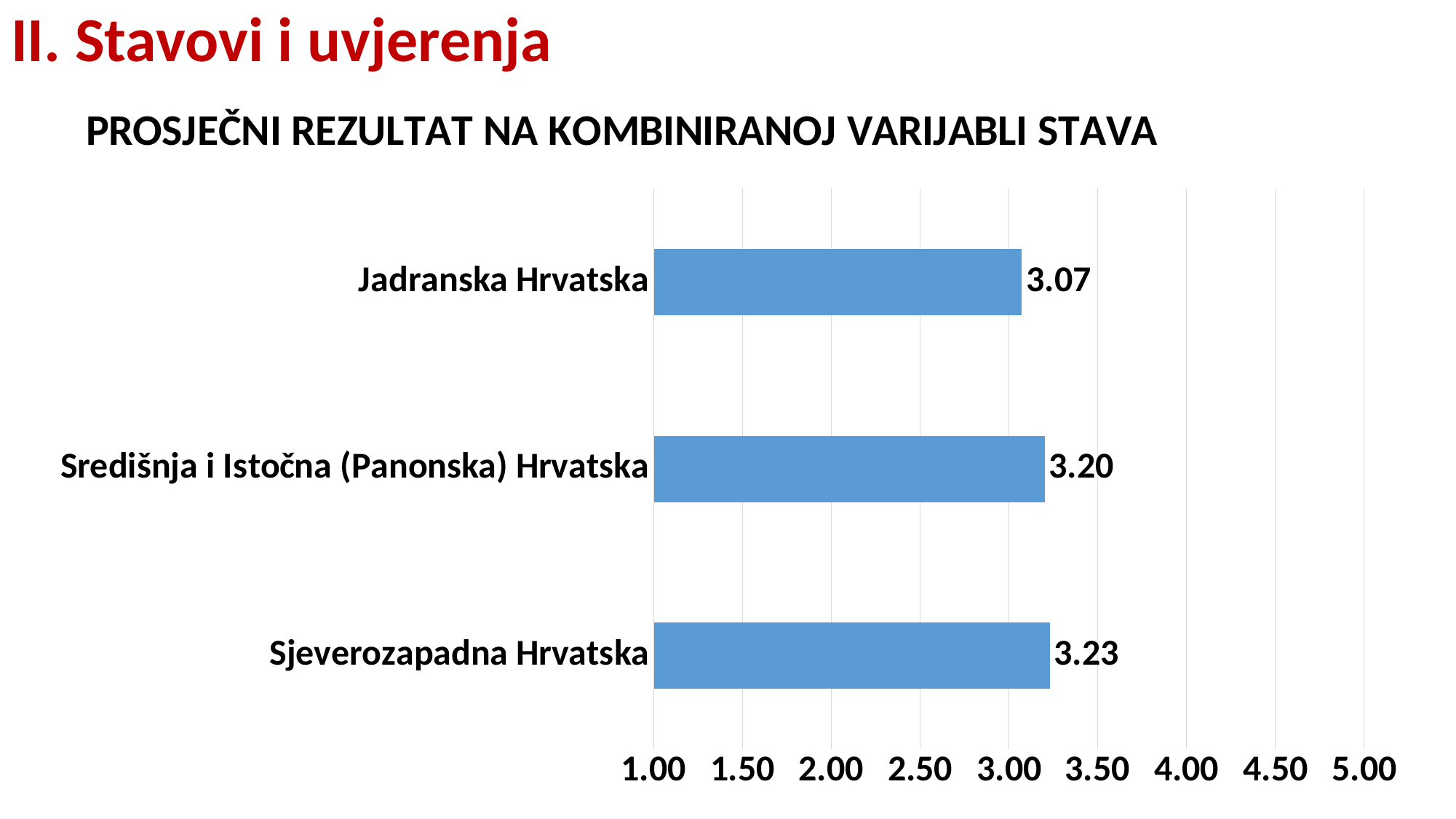
Which is larger, the value for Središnja i Istočna (Panonska) Hrvatska or the value for Jadranska Hrvatska? Središnja i Istočna (Panonska) Hrvatska What is the title of the chart? PROSJEČNI REZULTAT NA KOMBINIRANOJ VARIJABLI STAVA How many regions are shown in the chart? 3 What is the difference between the values for Središnja i Istočna (Panonska) Hrvatska and Jadranska Hrvatska? 0.13 What kind of chart is shown on the slide? bar chart What is the value for Središnja i Istočna (Panonska) Hrvatska? 3.20 Which region has the highest value? Sjeverozapadna Hrvatska Which region has the lowest value? Jadranska Hrvatska Is the value for Sjeverozapadna Hrvatska greater or less than 3.50? less What is the value for Sjeverozapadna Hrvatska? 3.23 What is the value for Jadranska Hrvatska? 3.07 What is the difference between the values for Sjeverozapadna Hrvatska and Jadranska Hrvatska? 0.16